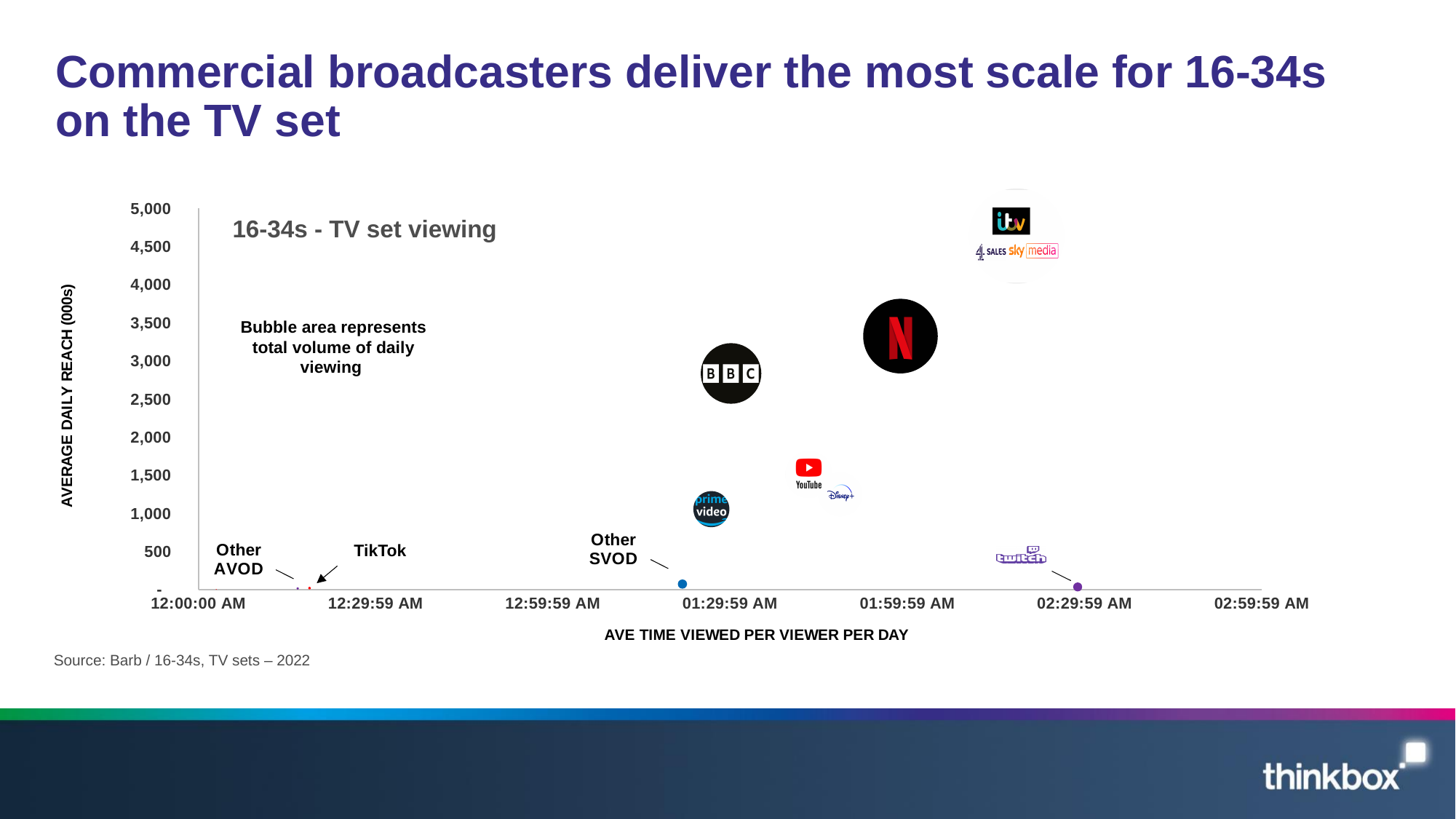
According to the note on the chart, what does the bubble area represent? Total volume of daily viewing Is the average daily reach for the commercial broadcasters (ITV / Channel 4 Sales / Sky Media) greater or less than 4,000? greater Which service or group has the highest average daily reach on the chart? ITV / Channel 4 Sales / Sky Media (commercial broadcasters) Is the average daily reach for Netflix greater or less than 3,000? greater Which service has the highest average time viewed per viewer per day (furthest right on the x axis)? Twitch Is the average daily reach for Prime Video greater or less than 500? greater What is the title shown inside the chart area? 16-34s - TV set viewing Which has the larger average daily reach, Netflix or BBC? Netflix Which has the longer average time viewed per viewer per day, Twitch or Prime Video? Twitch What kind of chart is shown on the slide? Bubble chart